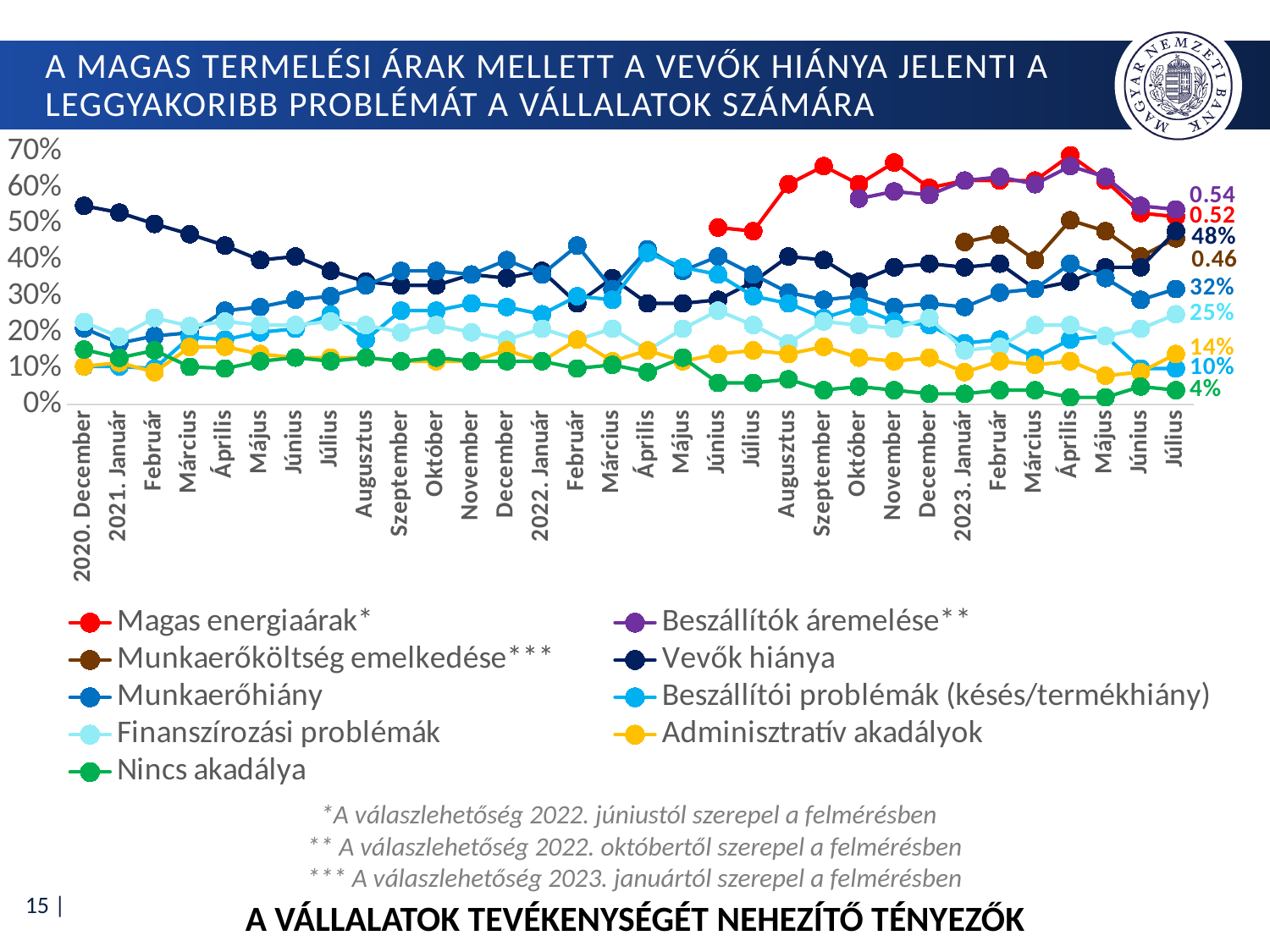
Is the value for Vevők hiánya in 2020. December greater or less than 50%? greater Does the Vevők hiánya series rise or fall between 2020. December and 2021. Július? fall What is the difference between the end-of-series labels for Munkaerőhiány (32%) and Finanszírozási problémák (25%)? 7 percentage points What kind of chart is shown on the slide? line chart What is the value labelled for Vevők hiánya at the end of the series (2023. Július)? 48% What is the value labelled for Munkaerőhiány at the end of the series (2023. Július)? 32% What is the value labelled for Nincs akadálya at the end of the series (2023. Július)? 4% What is the value labelled for Magas energiaárak at the end of the series (2023. Július)? 0.52 Which series has the lowest labelled value at 2023. Július? Nincs akadálya Which series has the highest labelled value at 2023. Július? Beszállítók áremelése What is the value labelled for Beszállítók áremelése at the end of the series (2023. Július)? 0.54 How many series does the legend list? 9